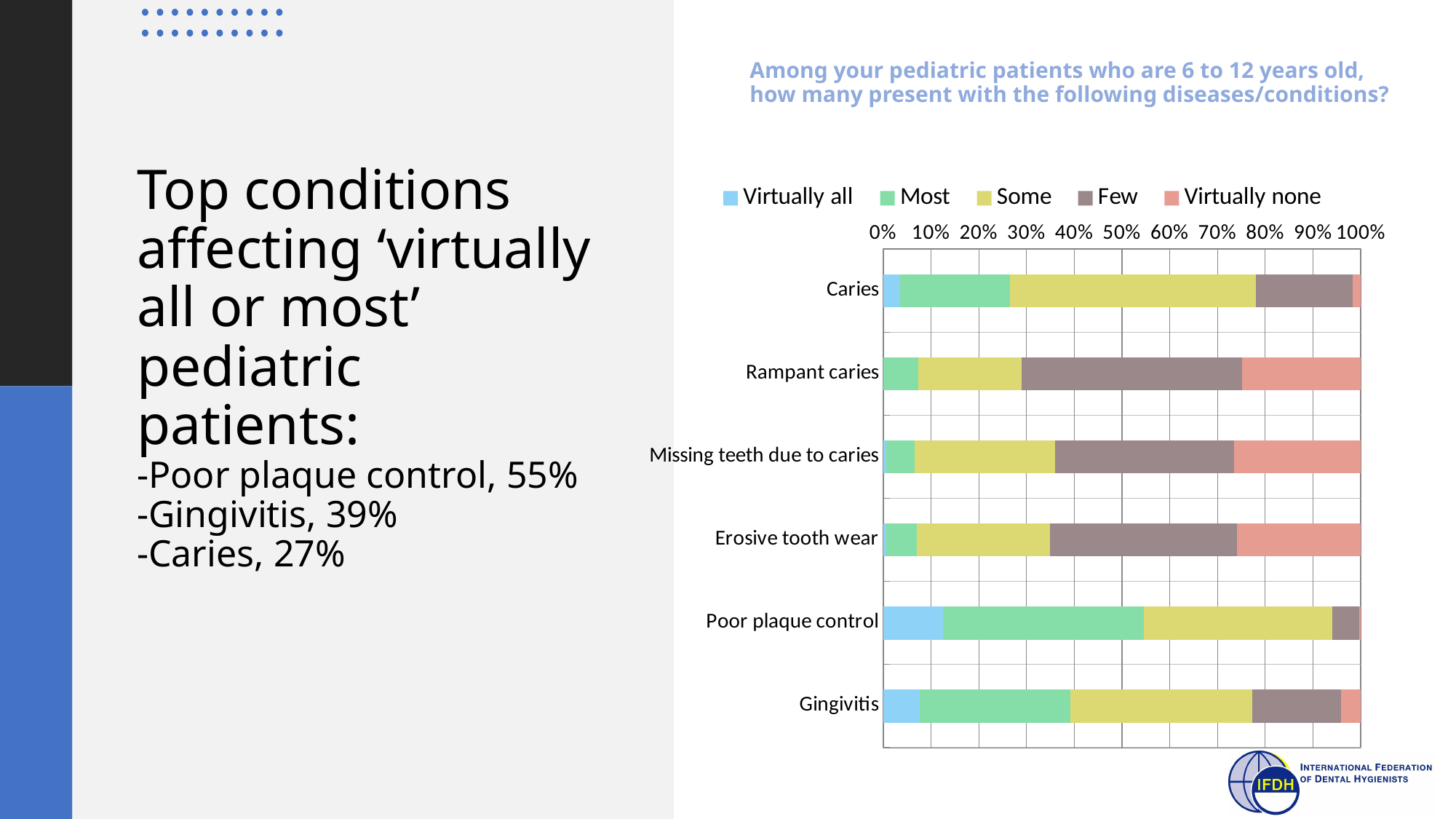
How many series does the chart legend list? 5 Which condition has the largest 'Most' segment? Poor plaque control Is the 'Most' segment larger for Poor plaque control or for Rampant caries? Poor plaque control How many diseases/conditions are listed on the chart's vertical axis? 6 Is the 'Some' segment for Caries greater or less than 40%? greater Is the 'Virtually none' segment for Caries greater or less than 10%? less Which legend entry is shown in the pink/salmon colour? Virtually none What is the question shown as the chart's title? Among your pediatric patients who are 6 to 12 years old, how many present with the following diseases/conditions? Which condition has the largest 'Virtually all' segment? Poor plaque control What kind of chart is shown on the slide? stacked bar chart Is the 'Virtually none' segment larger for Rampant caries or for Caries? Rampant caries Which condition has the largest 'Few' segment? Rampant caries